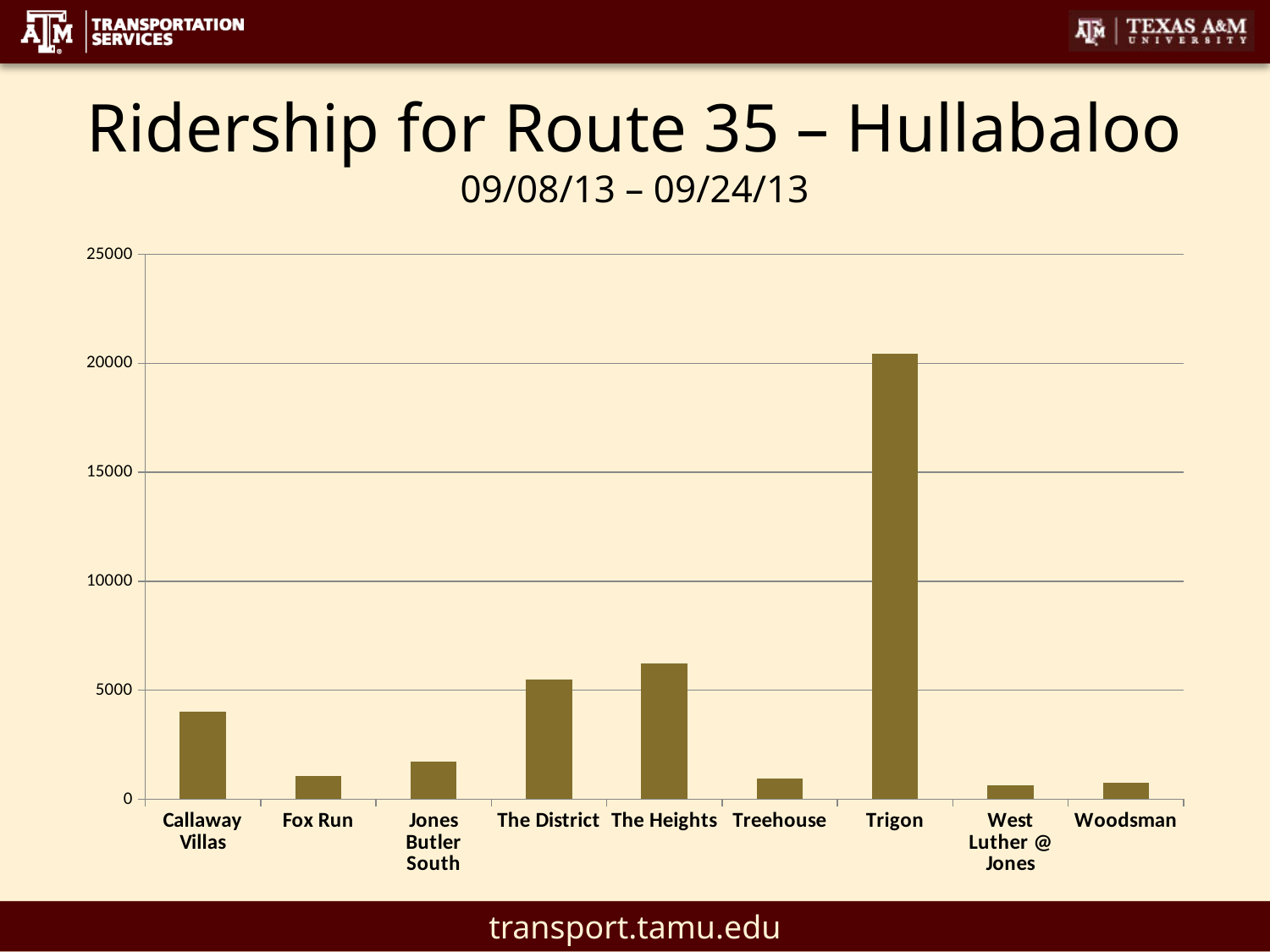
Is the value for The Heights greater or less than 5000? greater What kind of chart is shown on the slide? bar chart Is the value for The District greater or less than 5000? greater Is the value for Fox Run greater or less than 5000? less How many stops (categories) are shown on the x axis of the chart? 9 What is the title of the chart on the slide? Ridership for Route 35 – Hullabaloo Which has a higher value, The Heights or The District? The Heights Which has a higher value, Callaway Villas or Fox Run? Callaway Villas Which stop has the highest ridership in the chart? Trigon What date range does the chart cover? 09/08/13 – 09/24/13